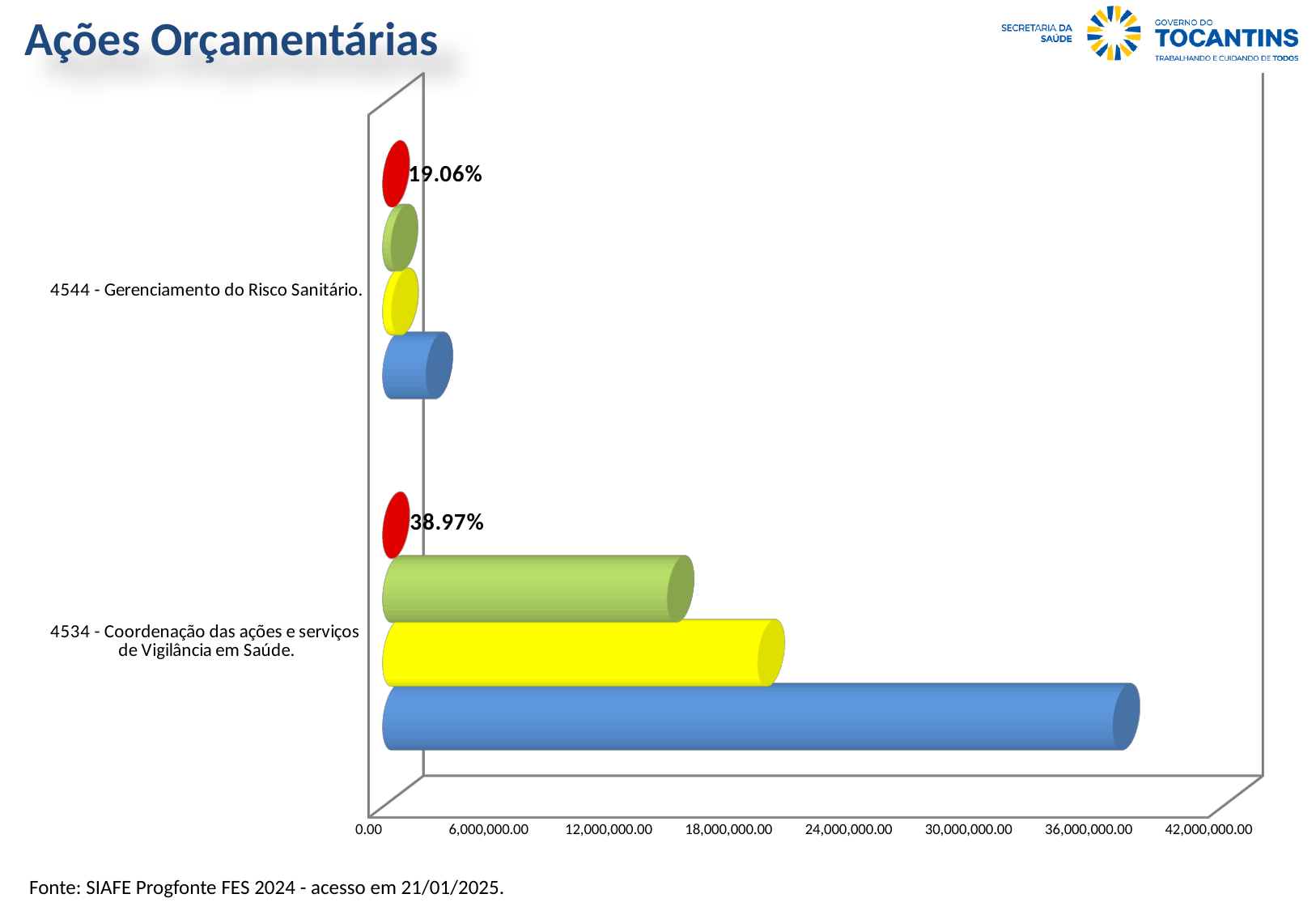
Is the value of the green bar for '4534 - Coordenação das ações e serviços de Vigilância em Saúde.' greater or less than 18,000,000.00? less Is the value of the blue bar for '4544 - Gerenciamento do Risco Sanitário.' greater or less than 6,000,000.00? less Which category has the lower percentage label? 4544 - Gerenciamento do Risco Sanitário. How many categories are shown on the vertical axis of the chart? 2 What is the title of the slide containing the chart? Ações Orçamentárias Is the value of the blue bar for '4534 - Coordenação das ações e serviços de Vigilância em Saúde.' greater or less than 30,000,000.00? greater Which category has the higher percentage label? 4534 - Coordenação das ações e serviços de Vigilância em Saúde. What percentage label is shown for the category '4544 - Gerenciamento do Risco Sanitário.'? 19.06% What percentage label is shown for the category '4534 - Coordenação das ações e serviços de Vigilância em Saúde.'? 38.97% Which category has the longer blue bar? 4534 - Coordenação das ações e serviços de Vigilância em Saúde. What kind of chart is shown on the slide? Bar chart What is the difference between the two percentage labels shown on the chart? 19.91%